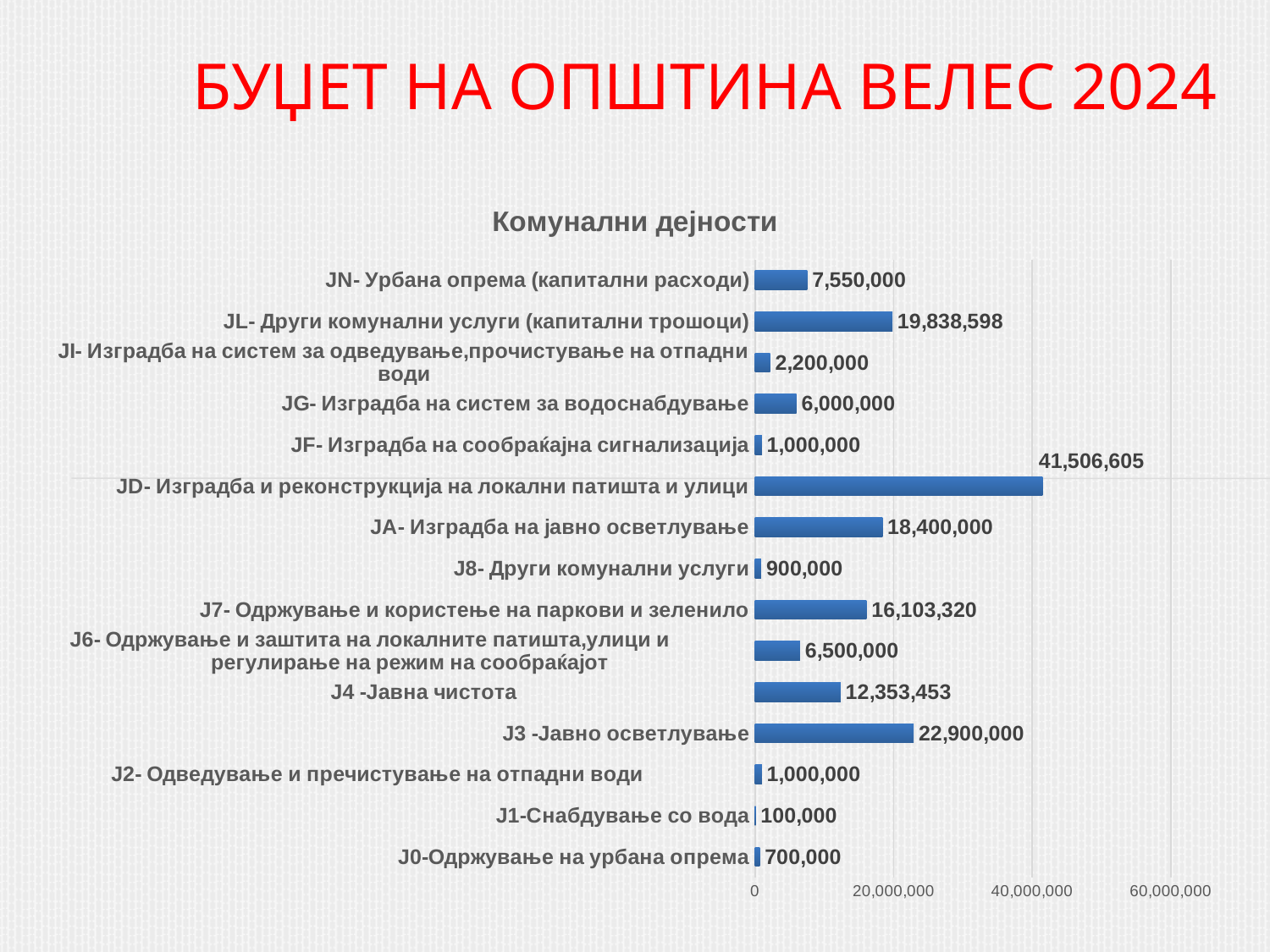
Which category has the lowest value? J1-Снабдување со вода What kind of chart is shown on the slide? bar chart Which category has the highest value? JD- Изградба и реконструкција на локални патишта и улици How many categories are shown in the chart? 15 What is the difference between the values for J3 -Јавно осветлување and JA- Изградба на јавно осветлување? 4,500,000 Which is larger, the value for J3 -Јавно осветлување or the value for JA- Изградба на јавно осветлување? J3 -Јавно осветлување What is the title of the chart? Комунални дејности What is the value for J4 -Јавна чистота? 12,353,453 What is the difference between the values for JL- Други комунални услуги (капитални трошоци) and J7- Одржување и користење на паркови и зеленило? 3,735,278 Is the value for JD- Изградба и реконструкција на локални патишта и улици greater or less than 40,000,000? greater What is the value for JL- Други комунални услуги (капитални трошоци)? 19,838,598 What is the value for JD- Изградба и реконструкција на локални патишта и улици? 41,506,605